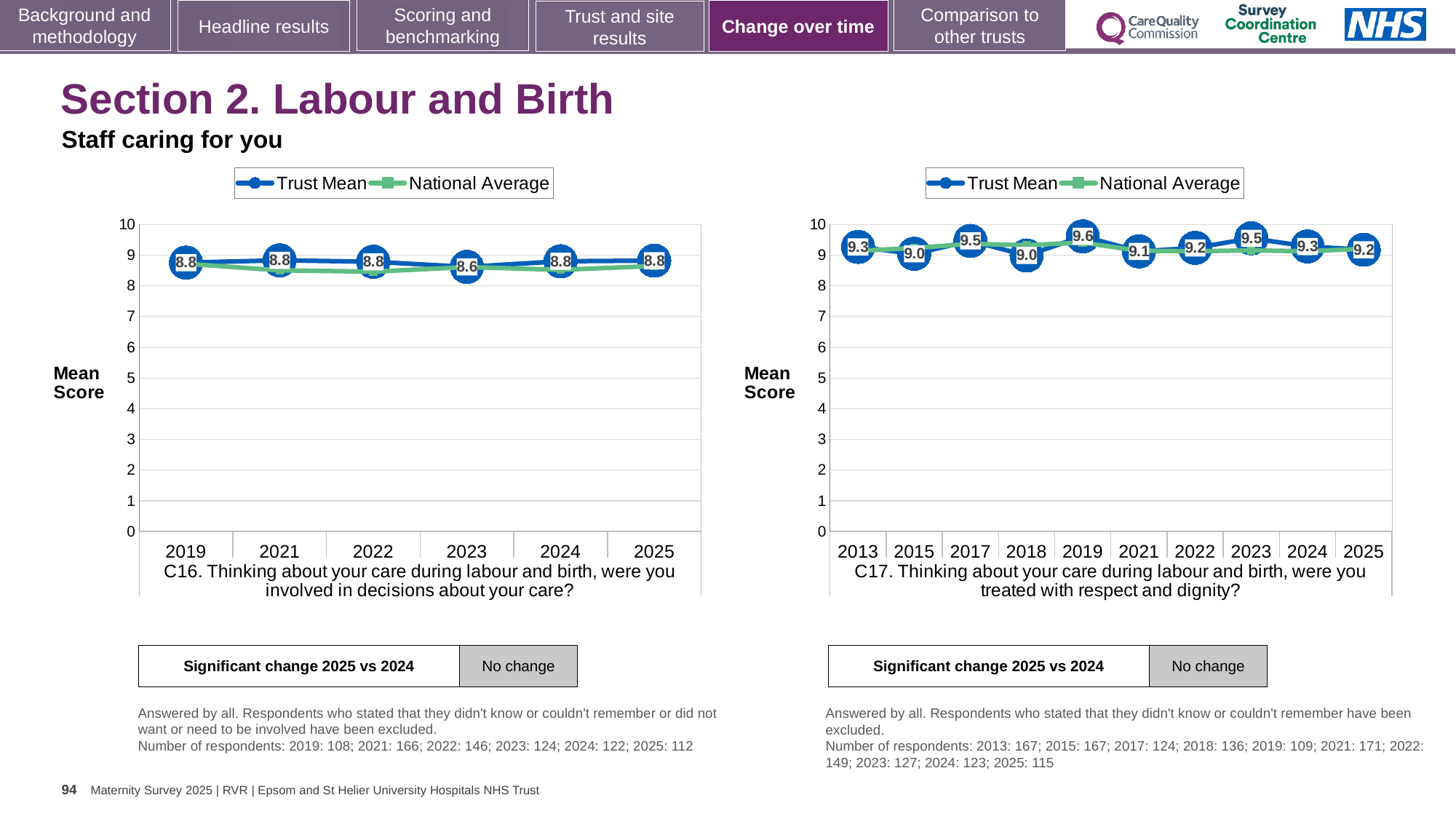
In the C17 chart on the right, what is the Trust Mean score for 2019? 9.6 In the C16 chart on the left, which year has the lowest Trust Mean score? 2023 In the C17 chart on the right, what is the difference between the Trust Mean scores for 2019 and 2015? 0.6 In the C17 chart on the right, which year has the highest Trust Mean score? 2019 How many years are plotted on the x axis of the C17 chart on the right? 10 In the C16 chart on the left, what is the difference between the Trust Mean scores for 2022 and 2023? 0.2 In the C16 chart on the left, what is the Trust Mean score for 2023? 8.6 How many series does the legend of the C16 chart on the left list? 2 In the C16 chart on the left, is the Trust Mean score for 2019 greater or less than 8? greater In the C16 chart on the left, does the Trust Mean score rise or fall from 2022 to 2023? Fall What kind of chart is the C16 chart on the left? Line chart In the C17 chart on the right, which year has the larger Trust Mean score, 2017 or 2018? 2017